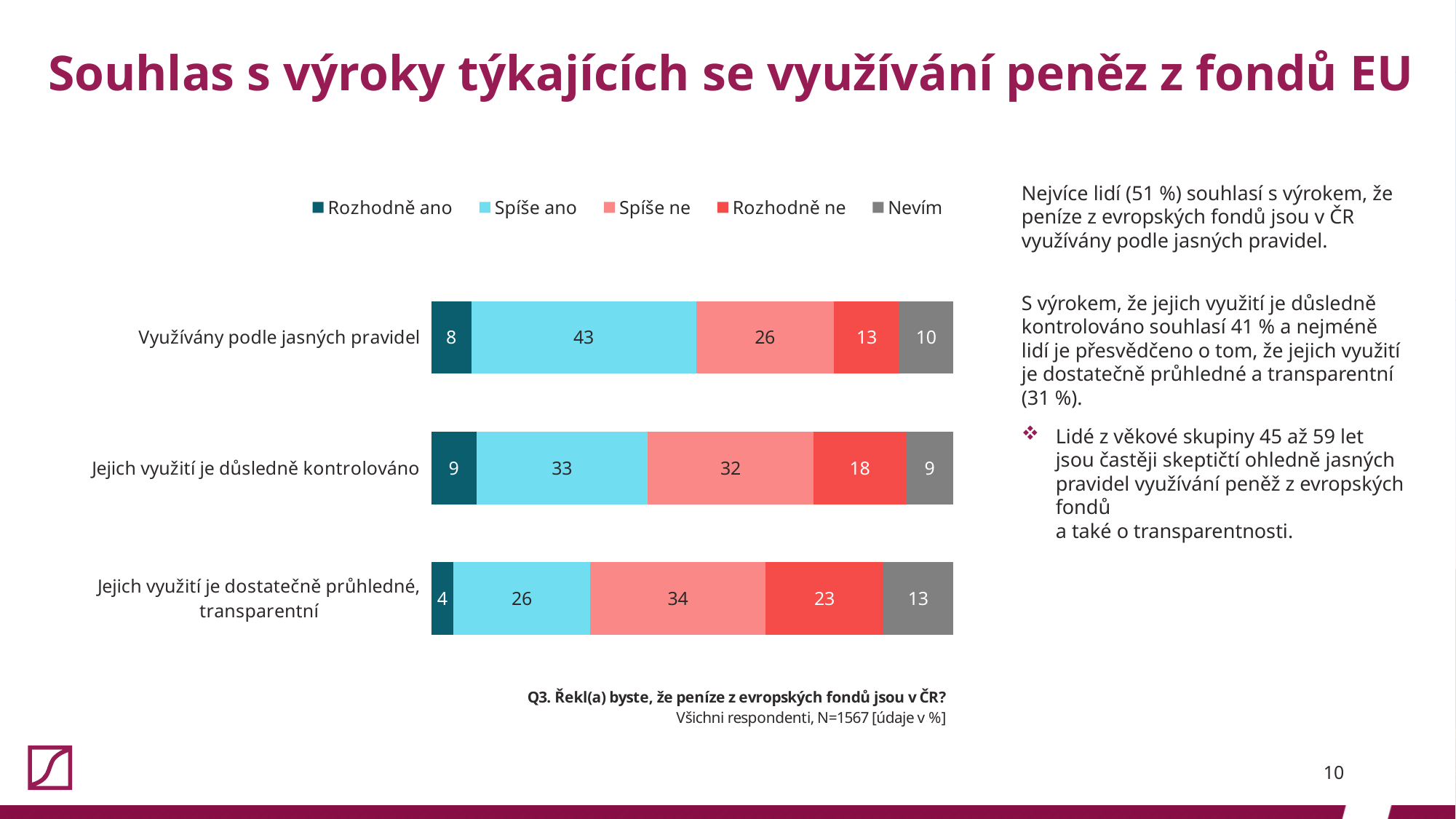
How many statements (bars) are shown in the chart? 3 Which statement has the lowest value for "Rozhodně ano"? Jejich využití je dostatečně průhledné, transparentní How many series does the legend list? 5 What is the value for "Rozhodně ne" in the "Jejich využití je důsledně kontrolováno" bar? 18 Which is larger: "Rozhodně ne" for "Jejich využití je dostatečně průhledné, transparentní" or "Rozhodně ne" for "Využívány podle jasných pravidel"? Jejich využití je dostatečně průhledné, transparentní What is the difference between the "Spíše ano" values for "Využívány podle jasných pravidel" and "Jejich využití je důsledně kontrolováno"? 10 What kind of chart is shown on the slide? Stacked bar chart What is the value for "Spíše ano" in the "Využívány podle jasných pravidel" bar? 43 Which statement has the highest value for "Spíše ne"? Jejich využití je dostatečně průhledné, transparentní What is the value for "Nevím" in the "Jejich využití je dostatečně průhledné, transparentní" bar? 13 What is the sample size (N) stated below the chart? N=1567 What is the total of "Rozhodně ano" and "Spíše ano" for "Jejich využití je důsledně kontrolováno"? 42